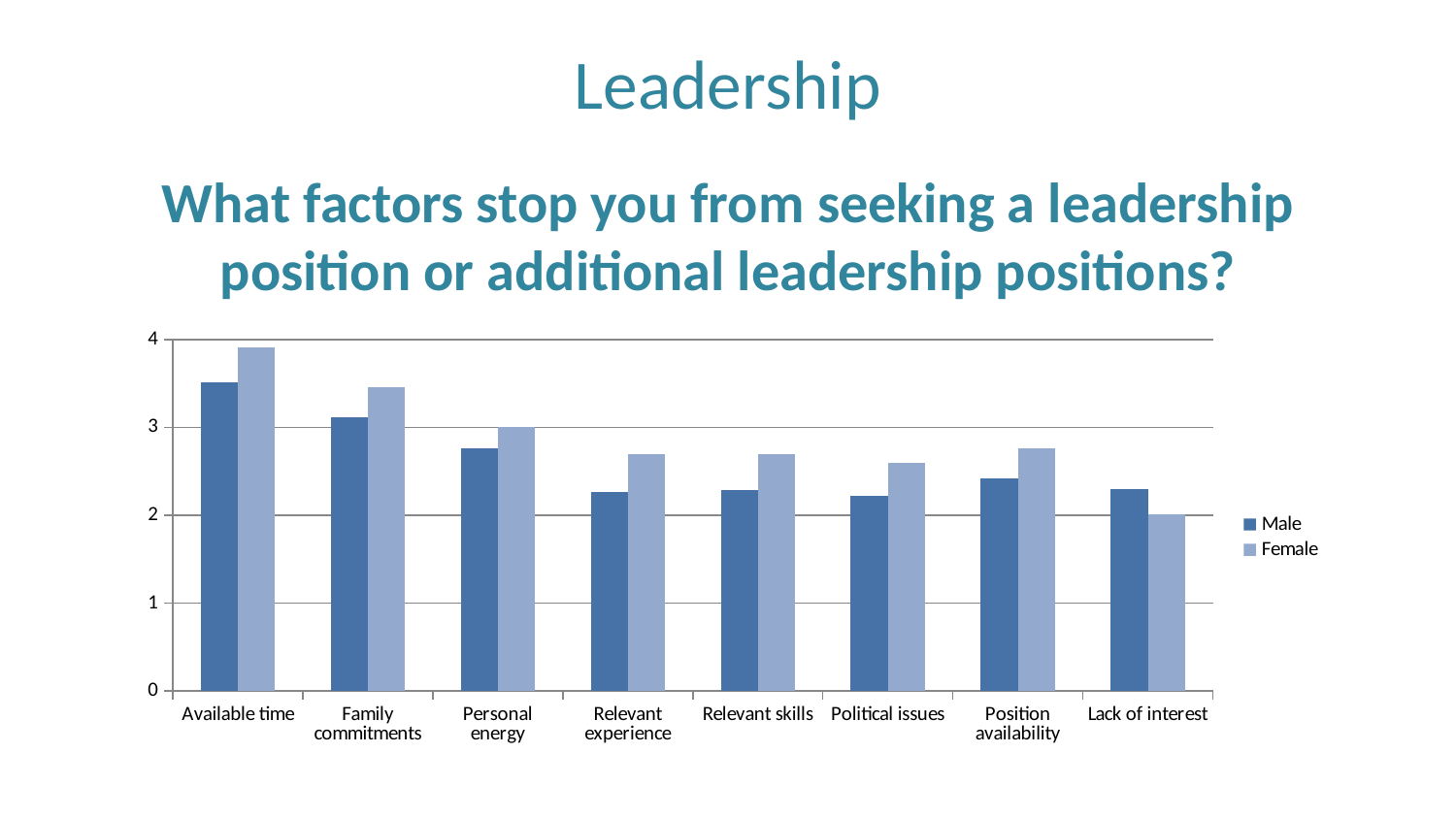
For Available time, which is larger, the Male value or the Female value? Female Which category has the highest Male value? Available time Is the Female value for Available time greater or less than 3? greater Which category has the lowest Female value? Lack of interest Is the Male value for Relevant experience greater or less than 3? less For Lack of interest, which is larger, the Male value or the Female value? Male How many factor categories are shown on the x axis? 8 What kind of chart is shown on the slide? bar chart Which category has the highest Female value? Available time How many series does the legend list? 2 What are the two series named in the legend? Male and Female Is the Female value for Position availability greater or less than 3? less